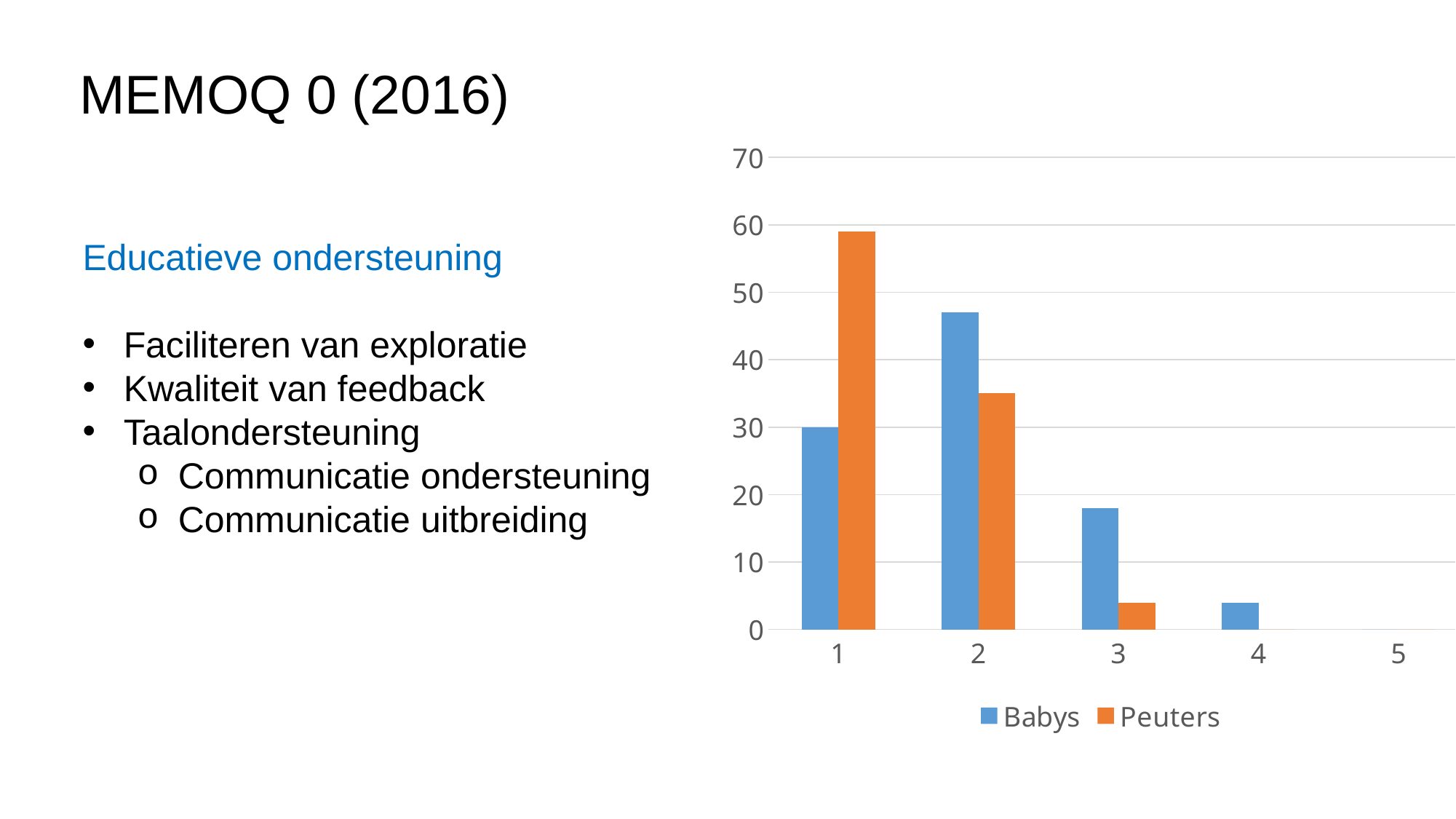
Is the value for Babys at category 3 greater or less than 20? less What kind of chart is shown on the slide? bar chart Do the values for the Peuters series rise or fall from category 1 to category 5? fall At category 2, which series has the larger value, Babys or Peuters? Babys How many series does the chart legend list? 2 Which category has the highest value for the Peuters series? 1 Which category has the highest value for the Babys series? 2 Is the value for Peuters at category 1 greater or less than 50? greater Is the value for Peuters at category 2 greater or less than 40? less Which colour represents the Babys series in the chart? blue At category 1, which series has the larger value, Babys or Peuters? Peuters How many categories are shown on the x axis of the chart? 5